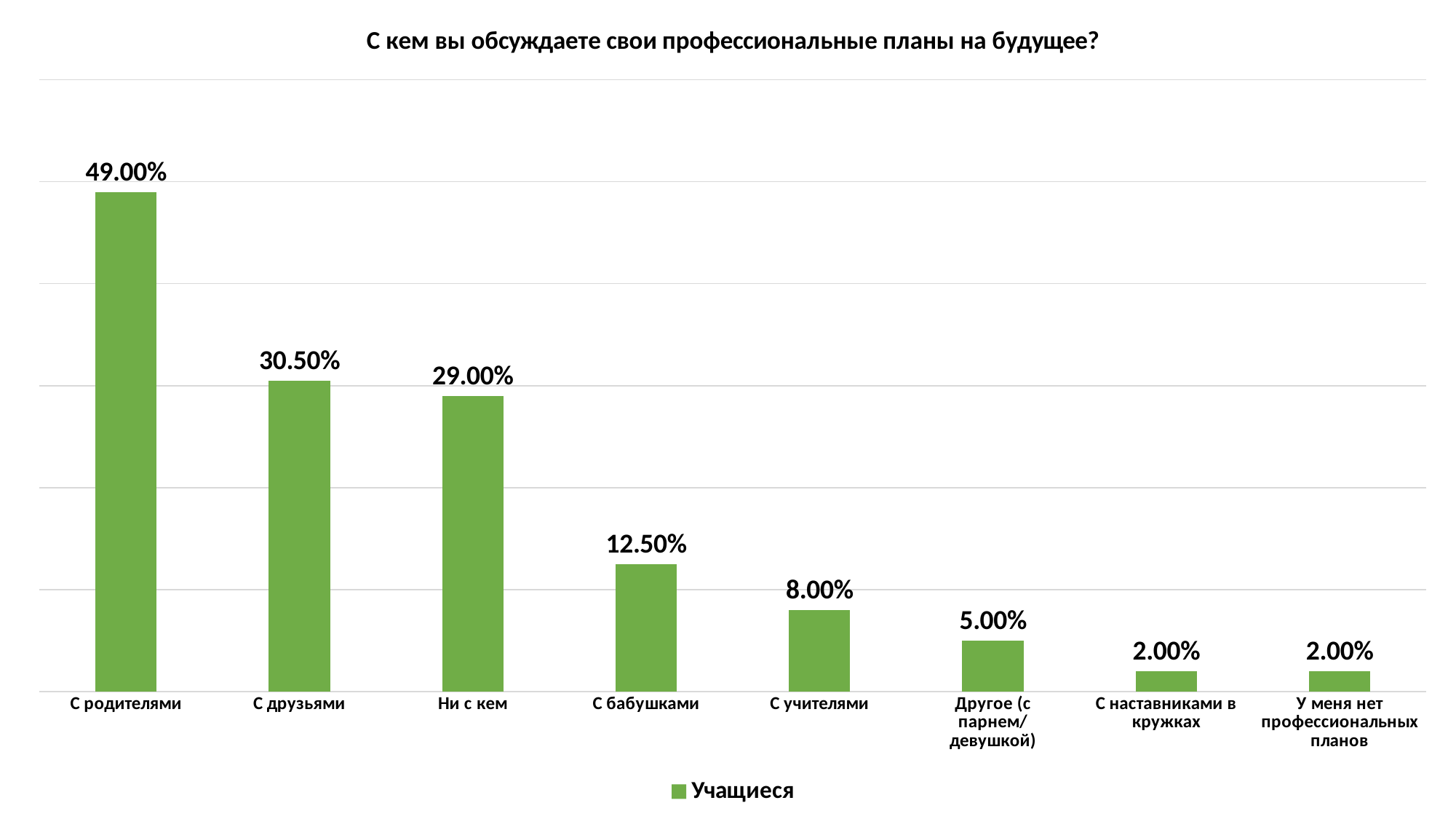
How many categories are shown on the x axis? 8 What is the value for "С родителями"? 49.00% What is the value for "С друзьями"? 30.50% What is the value for "С бабушками"? 12.50% What is the title of the chart? С кем вы обсуждаете свои профессиональные планы на будущее? What is the value for "С учителями"? 8.00% What is the difference between the values for "С родителями" and "С друзьями"? 18.50% How many series does the legend list? 1 Which is larger, the value for "С бабушками" or the value for "С учителями"? С бабушками Which category has the highest value? С родителями What type of chart is shown on the slide? Bar chart What is the difference between the values for "С друзьями" and "Ни с кем"? 1.50%